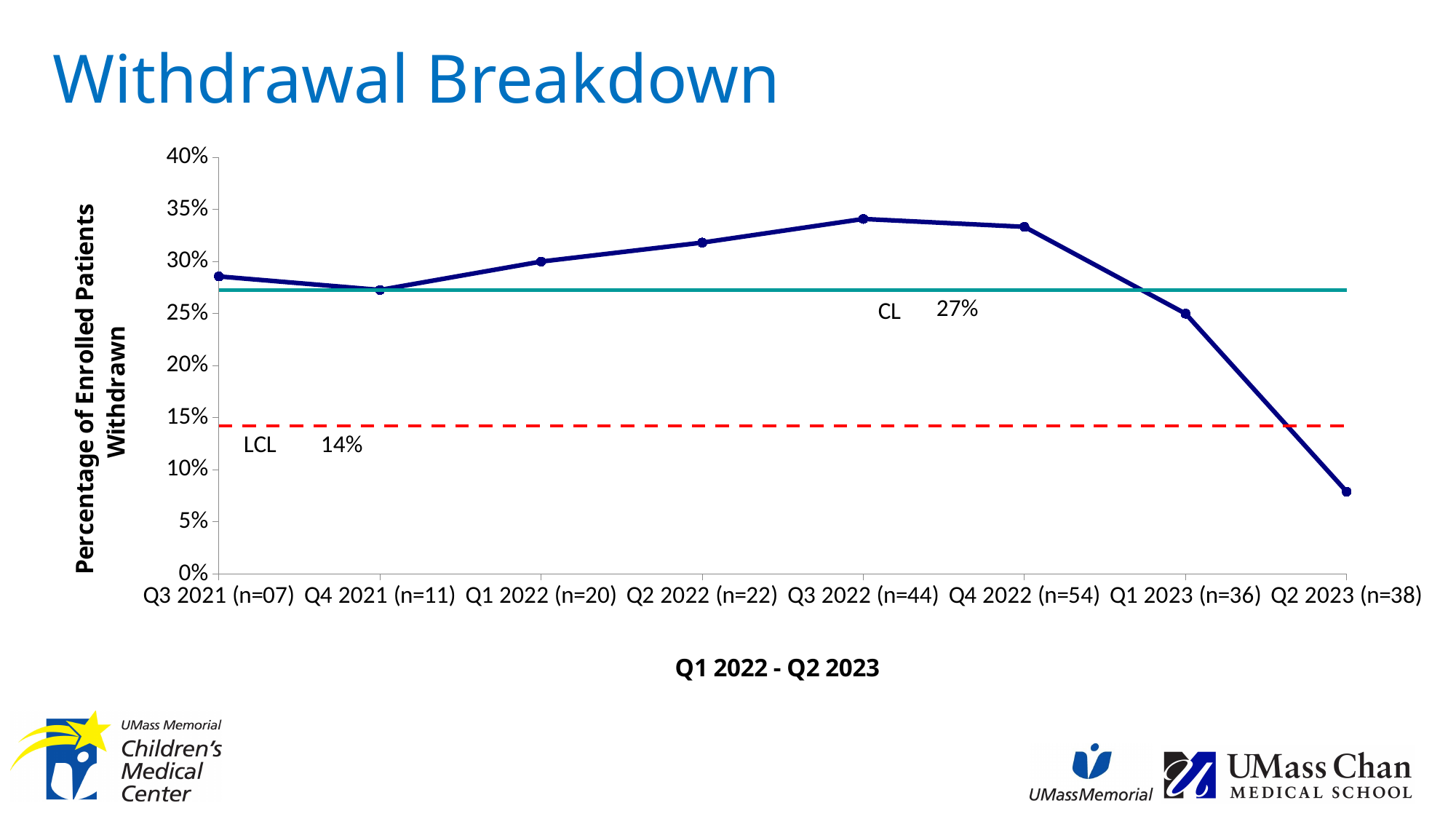
How many quarterly data points are plotted on the line? 8 Which quarter has the lowest percentage of enrolled patients withdrawn? Q2 2023 (n=38) Is the value for Q3 2022 (n=44) greater or less than 30%? greater Which is larger, the value for Q3 2022 (n=44) or the value for Q1 2023 (n=36)? Q3 2022 (n=44) What value is labelled for the LCL? 14% Which quarter has the highest percentage of enrolled patients withdrawn? Q3 2022 (n=44) What value is labelled for the CL (center line)? 27% Is the value for Q2 2023 (n=38) greater or less than 10%? less Is the value for Q1 2023 (n=36) greater or less than 20%? greater Do the values rise or fall from Q4 2022 (n=54) to Q2 2023 (n=38)? fall What is the title of the y axis? Percentage of Enrolled Patients Withdrawn What kind of chart is shown on the slide? line chart